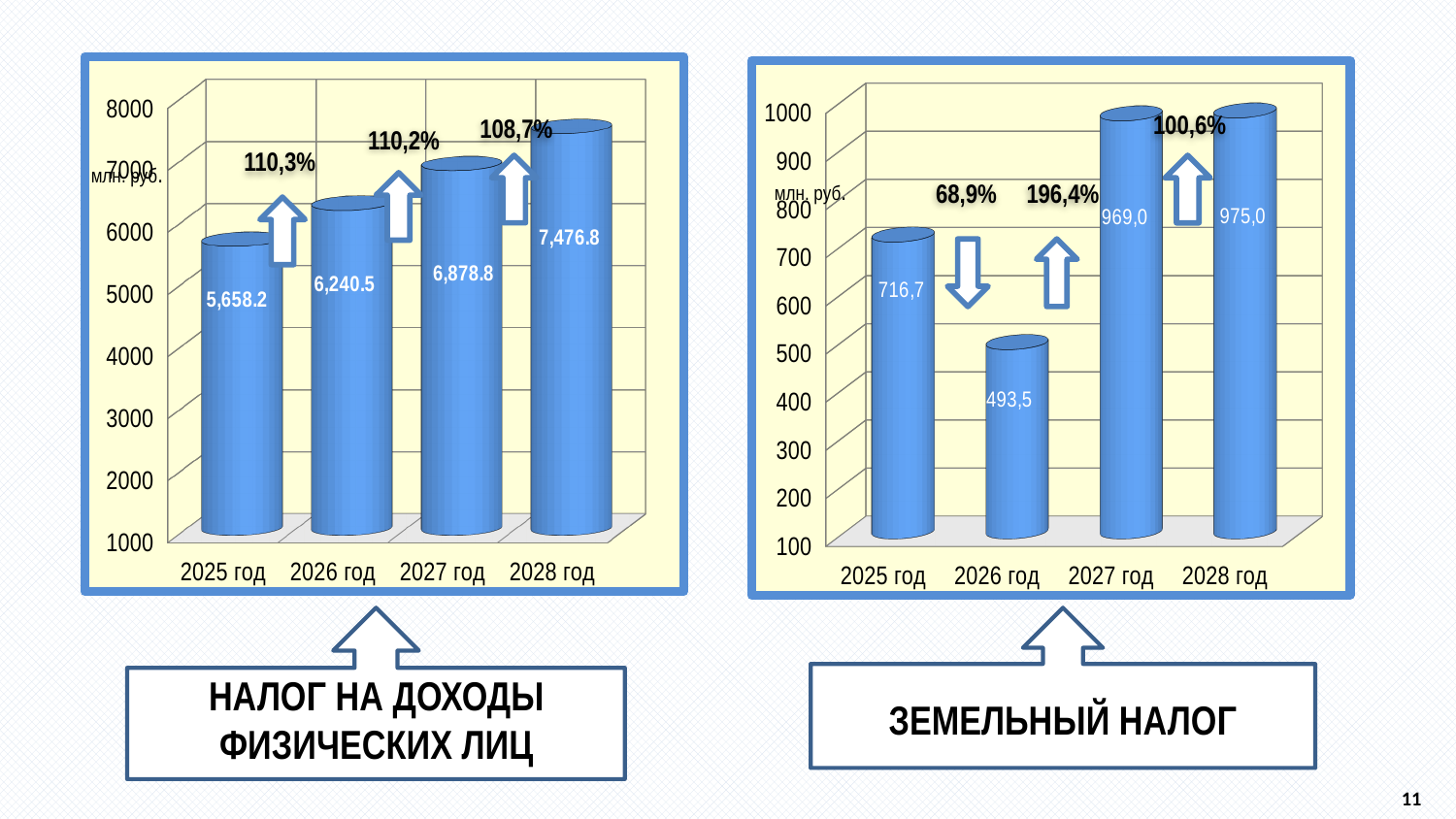
In the chart titled ЗЕМЕЛЬНЫЙ НАЛОГ, what is the value for 2027 год? 969,0 In the chart titled НАЛОГ НА ДОХОДЫ ФИЗИЧЕСКИХ ЛИЦ, do the values rise or fall from 2025 год to 2028 год? rise In the chart titled НАЛОГ НА ДОХОДЫ ФИЗИЧЕСКИХ ЛИЦ, which year has the highest value? 2028 год In the chart titled ЗЕМЕЛЬНЫЙ НАЛОГ, what is the value for 2025 год? 716,7 In the chart titled НАЛОГ НА ДОХОДЫ ФИЗИЧЕСКИХ ЛИЦ, what is the value for 2028 год? 7,476.8 In the chart titled ЗЕМЕЛЬНЫЙ НАЛОГ, which is larger, the value for 2025 год or the value for 2026 год? 2025 год In the chart titled ЗЕМЕЛЬНЫЙ НАЛОГ, is the value for 2026 год greater or less than 500? less In the chart titled ЗЕМЕЛЬНЫЙ НАЛОГ, which year has the lowest value? 2026 год In the chart titled НАЛОГ НА ДОХОДЫ ФИЗИЧЕСКИХ ЛИЦ, what is the value for 2026 год? 6,240.5 In the chart titled НАЛОГ НА ДОХОДЫ ФИЗИЧЕСКИХ ЛИЦ, what is the difference between the values for 2028 год and 2025 год? 1,818.6 In the chart titled ЗЕМЕЛЬНЫЙ НАЛОГ, what is the difference between the values for 2028 год and 2026 год? 481,5 How many years are shown in the chart titled ЗЕМЕЛЬНЫЙ НАЛОГ? 4